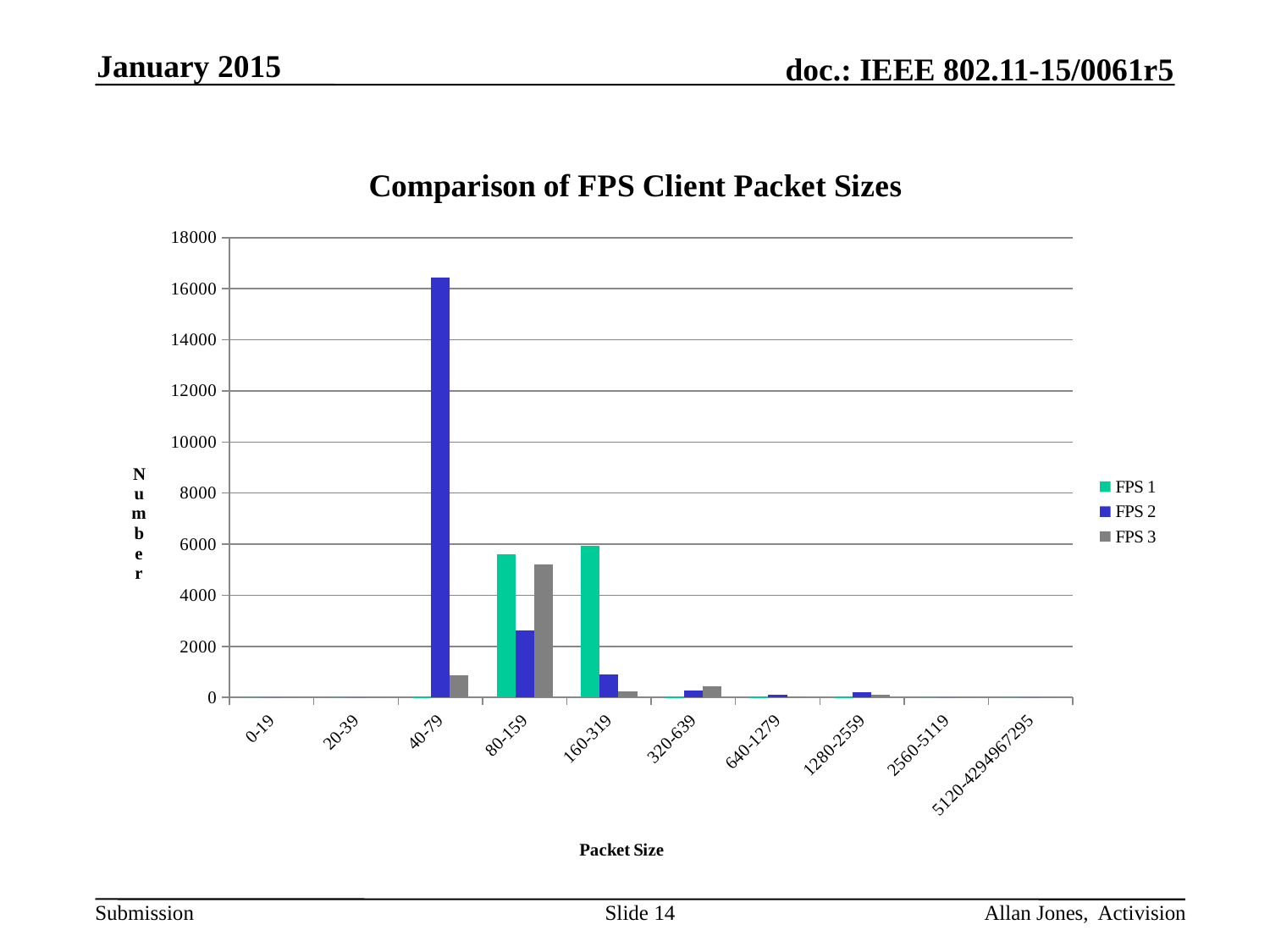
What is the title of the chart? Comparison of FPS Client Packet Sizes For which packet size category is the FPS 2 value highest? 40-79 How many series does the legend list? 3 For the 80-159 packet size, which series has the larger value, FPS 1 or FPS 2? FPS 1 For which packet size category is the FPS 3 value highest? 80-159 What is the label of the x axis? Packet Size Is the FPS 2 value for the 80-159 packet size greater or less than 4000? less For the 160-319 packet size, which series has the larger value, FPS 2 or FPS 3? FPS 2 What kind of chart is shown on the slide? bar chart How many packet size categories are shown on the x axis? 10 Is the FPS 1 value for the 80-159 packet size greater or less than 4000? greater Is the FPS 2 value for the 40-79 packet size greater or less than 16000? greater